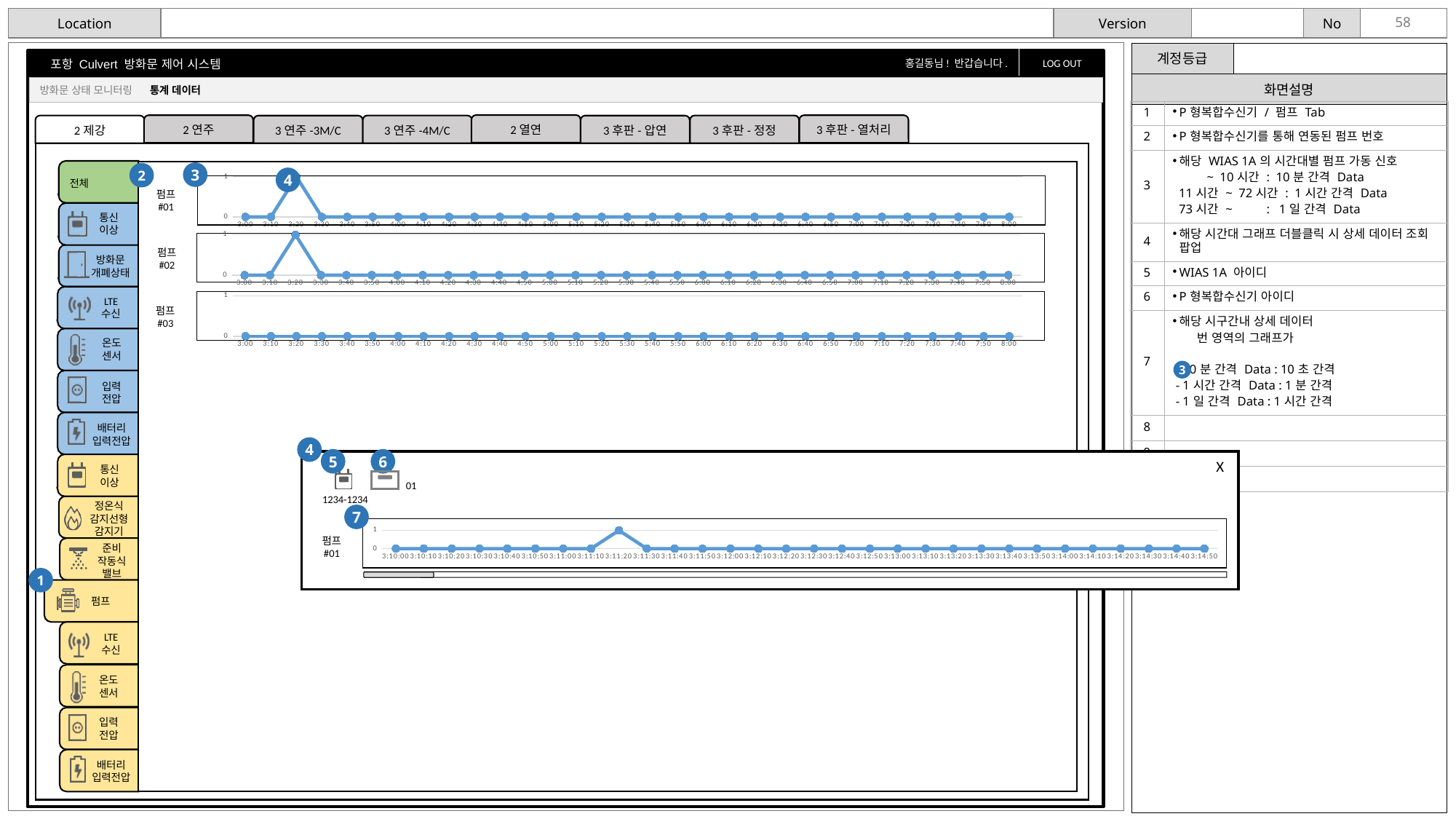
In the 펌프 #01 chart in the main area, which is larger, the value at 3:20 or the value at 3:30? 3:20 In the 펌프 #01 chart in the main area, what is the value at 3:20? 1 In the 펌프 #02 chart in the main area, what is the value at 3:20? 1 In the 펌프 #01 chart in the main area, what is the difference between the value at 3:20 and the value at 3:10? 1 What kind of chart is the 펌프 #01 chart in the main area? line chart In the 펌프 #01 chart in the main area, at which time is the value highest? 3:20 In the 펌프 #01 chart in the main area, what is the value at 3:00? 0 In the 펌프 #01 chart in the popup window, what is the value at 3:11:20? 1 In the 펌프 #03 chart in the main area, what is the value at 3:20? 0 How many pump line charts are shown in the main area (excluding the popup)? 3 In the 펌프 #02 chart in the main area, at which time is the value highest? 3:20 In the 펌프 #01 chart in the popup window, at which time is the value highest? 3:11:20